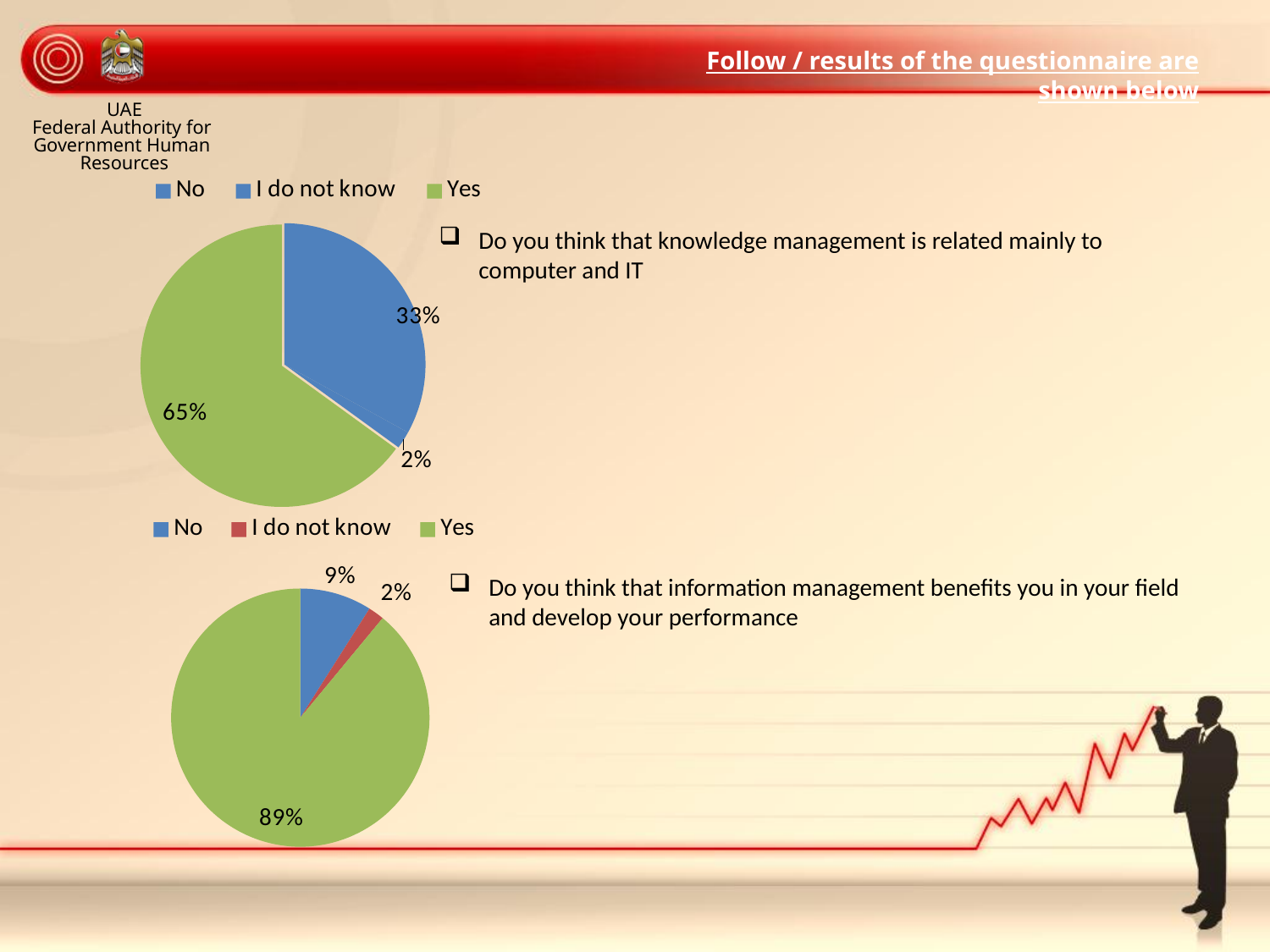
In the top pie chart, which category has the smallest slice? I do not know In the top pie chart, what percentage is shown for No? 33% In the top pie chart, what percentage is shown for I do not know? 2% What are the three legend entries for the bottom pie chart? No, I do not know, Yes In the top pie chart, what is the difference in percentage points between Yes and No? 32 In the bottom pie chart, which is larger, the No slice or the I do not know slice? No What type of chart is the top chart on the slide? Pie chart In the top pie chart, what percentage is shown for Yes? 65% In the bottom pie chart, what percentage is shown for Yes? 89% How many slices does the bottom pie chart have? 3 In the bottom pie chart, what percentage is shown for No? 9% In the bottom pie chart, which category has the largest slice? Yes